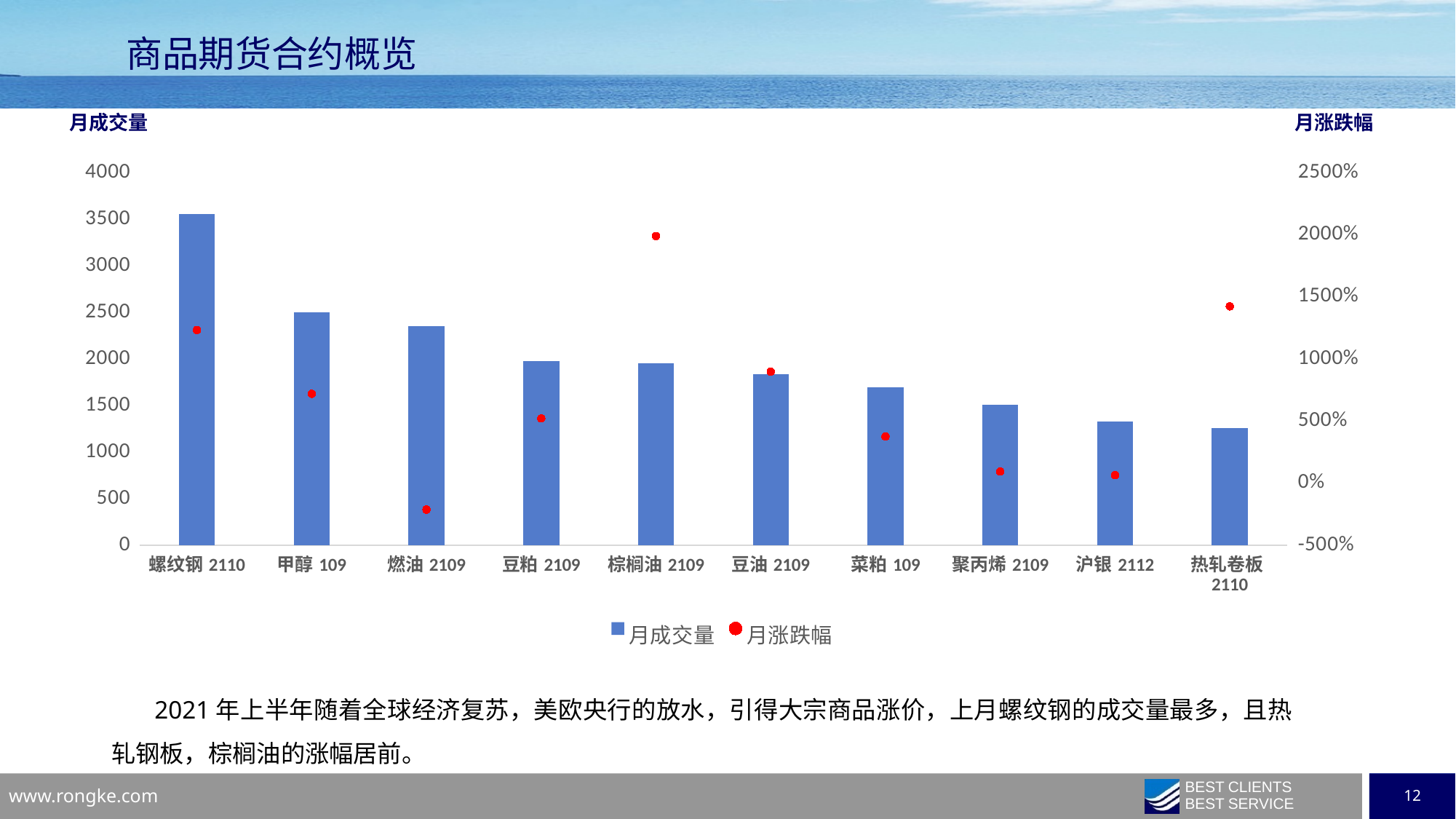
Is the 月成交量 value for 螺纹钢 2110 greater or less than 3000? greater Which contract has the highest 月涨跌幅 (red dot)? 棕榈油 2109 Is the 月涨跌幅 value for 热轧卷板 2110 greater or less than 1000%? greater Which contract has the lowest 月涨跌幅 (red dot)? 燃油 2109 How many series does the chart legend list? 2 Do the 月成交量 bars generally rise or fall from left to right across the x axis? fall What is the title of the right-hand vertical axis of the chart? 月涨跌幅 Is the 月涨跌幅 value for 燃油 2109 greater or less than 0%? less Which has the larger 月涨跌幅, 螺纹钢 2110 or 甲醇 109? 螺纹钢 2110 Which contract has the highest 月成交量 bar? 螺纹钢 2110 How many commodity contracts are shown on the x axis of the chart? 10